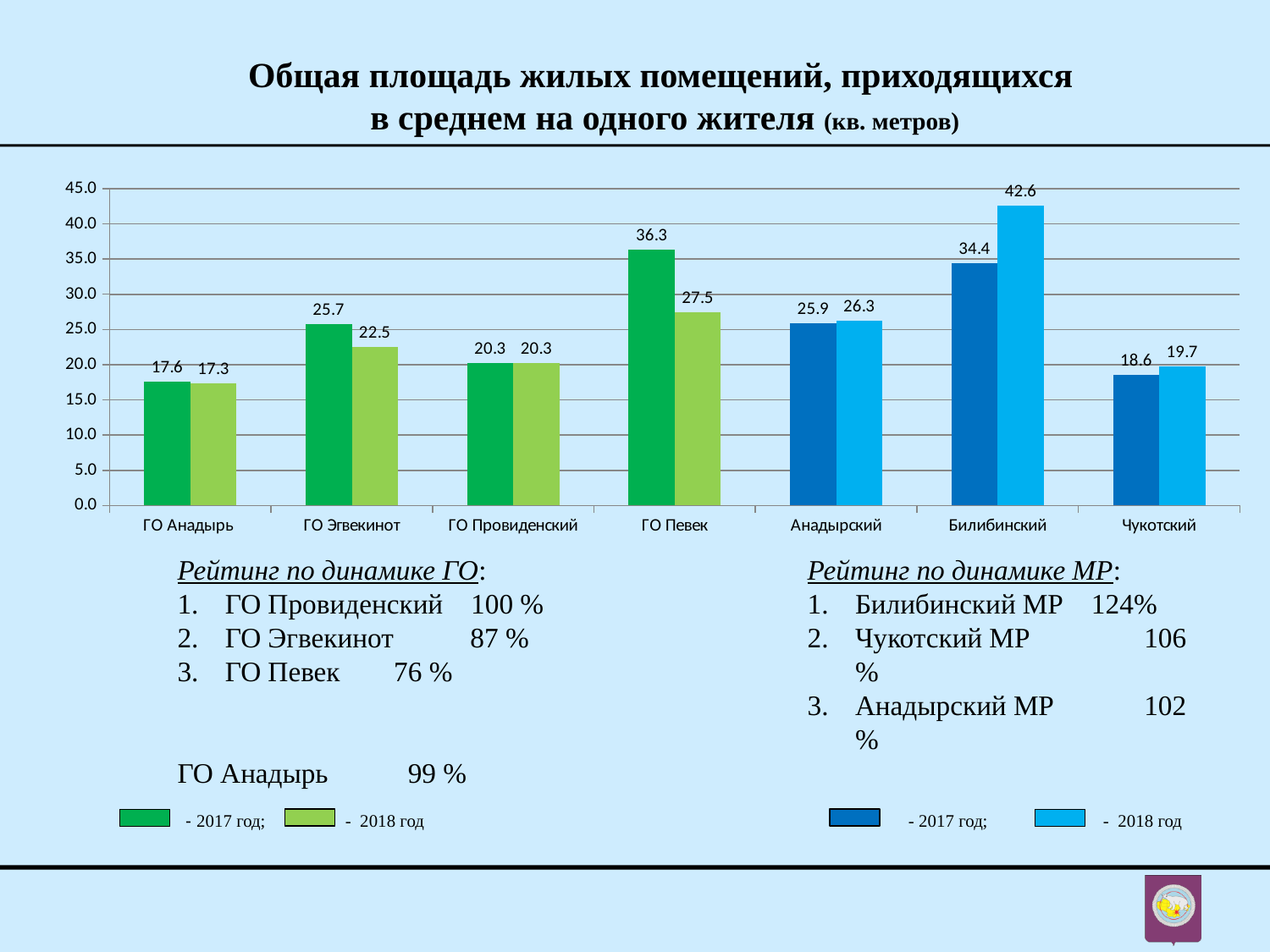
What is the 2018 value for ГО Провиденский? 20.3 Which is larger: the 2018 value for Анадырский or the 2018 value for ГО Эгвекинот? Анадырский What kind of chart is shown on the slide? bar chart Is the 2017 value for ГО Певек greater or less than 35.0? greater How many categories are shown on the x axis of the chart? 7 What is the 2017 value for ГО Певек? 36.3 What is the difference between the 2018 and 2017 values for Билибинский? 8.2 Which category has the lowest 2017 value? ГО Анадырь Which year does the dark green colour represent in the chart? 2017 год By how much did the value for ГО Певек fall from 2017 to 2018? 8.8 Which category has the highest 2018 value? Билибинский What is the 2018 value for Билибинский? 42.6